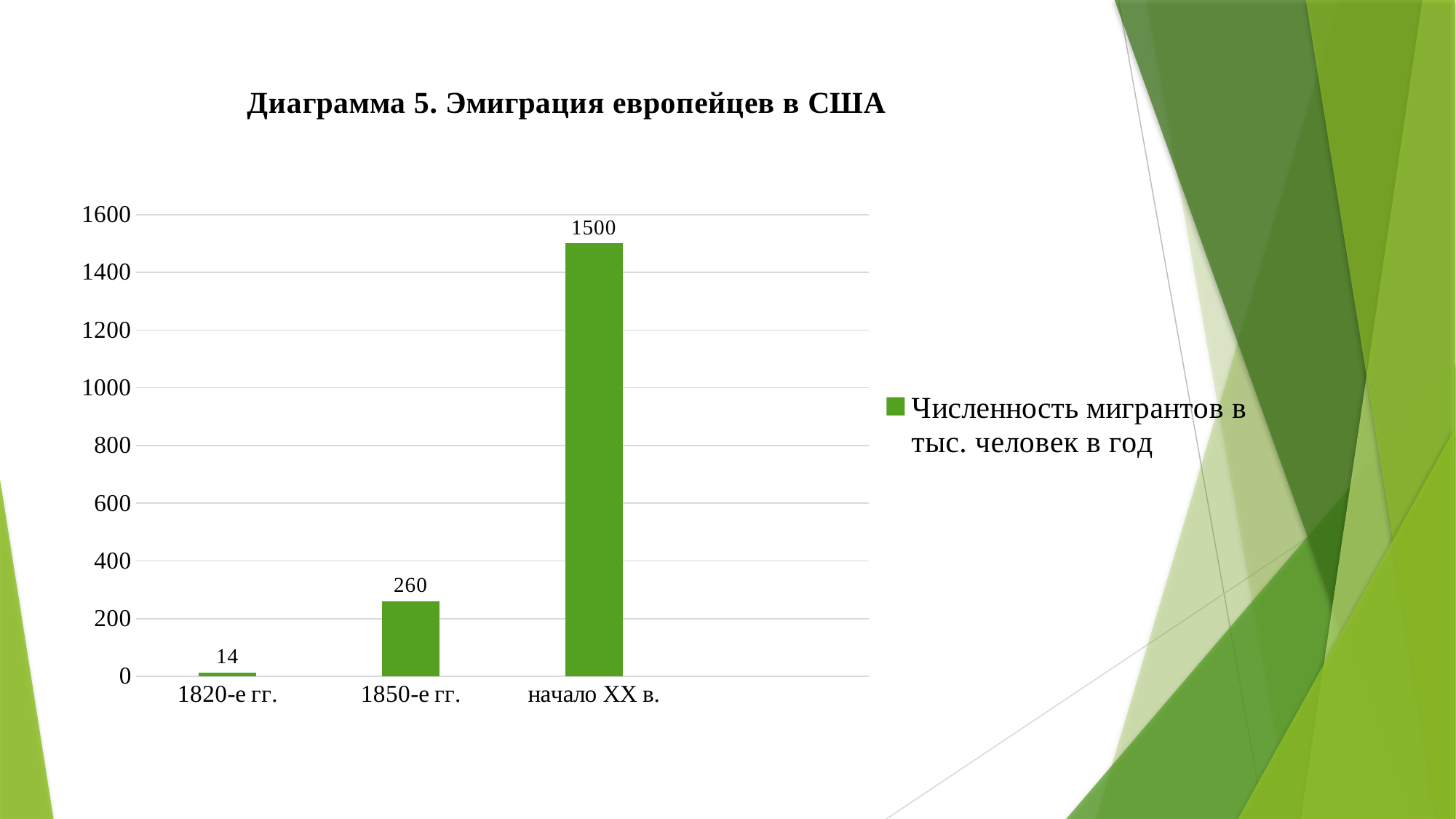
What is the value for начало XX в.? 1500 Is the value for начало XX в. greater or less than 1400? greater Which is larger, the value for 1850-е гг. or the value for 1820-е гг.? 1850-е гг. Which category has the highest value? начало XX в. Which category has the lowest value? 1820-е гг. What is the value for 1820-е гг.? 14 Do the values rise or fall from left to right along the x axis? rise What is the difference between the values for начало XX в. and 1850-е гг.? 1240 How many categories are shown on the x axis? 3 What kind of chart is shown on the slide? bar chart What is the value for 1850-е гг.? 260 What is the difference between the values for 1850-е гг. and 1820-е гг.? 246